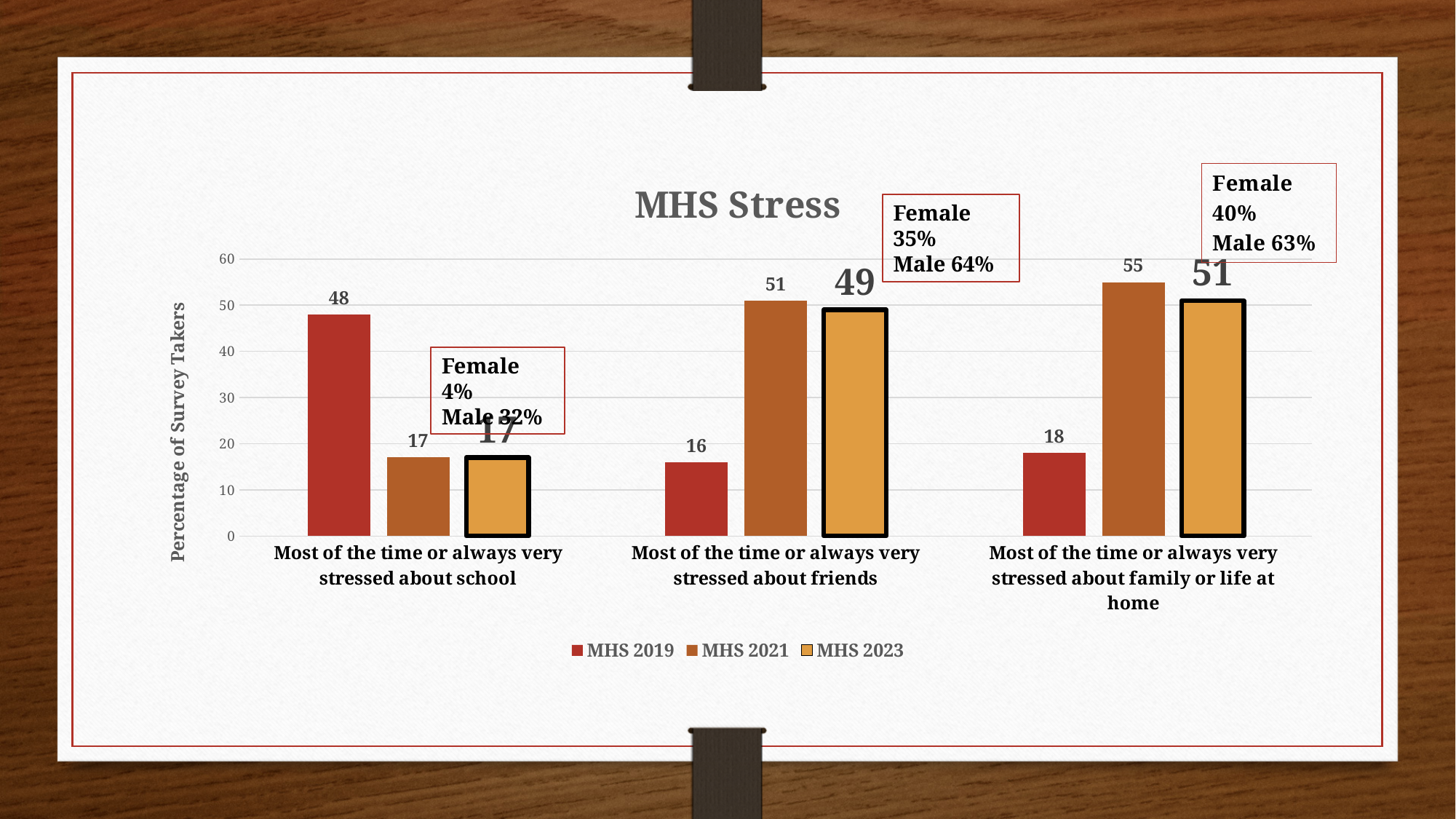
What is the MHS 2021 value for 'Most of the time or always very stressed about friends'? 51 Which category has the lowest MHS 2023 value? Most of the time or always very stressed about school Which is larger for 'Most of the time or always very stressed about family or life at home': the MHS 2021 value or the MHS 2023 value? MHS 2021 Which category has the highest MHS 2021 value? Most of the time or always very stressed about family or life at home What is the MHS 2023 value for 'Most of the time or always very stressed about family or life at home'? 51 What is the difference between the MHS 2019 and MHS 2021 values for 'Most of the time or always very stressed about school'? 31 What kind of chart is shown on the slide? Bar chart What is the MHS 2019 value for 'Most of the time or always very stressed about friends'? 16 What is the MHS 2019 value for 'Most of the time or always very stressed about school'? 48 How many categories are shown on the x axis? 3 How many series does the legend list? 3 What is the title of the chart? MHS Stress